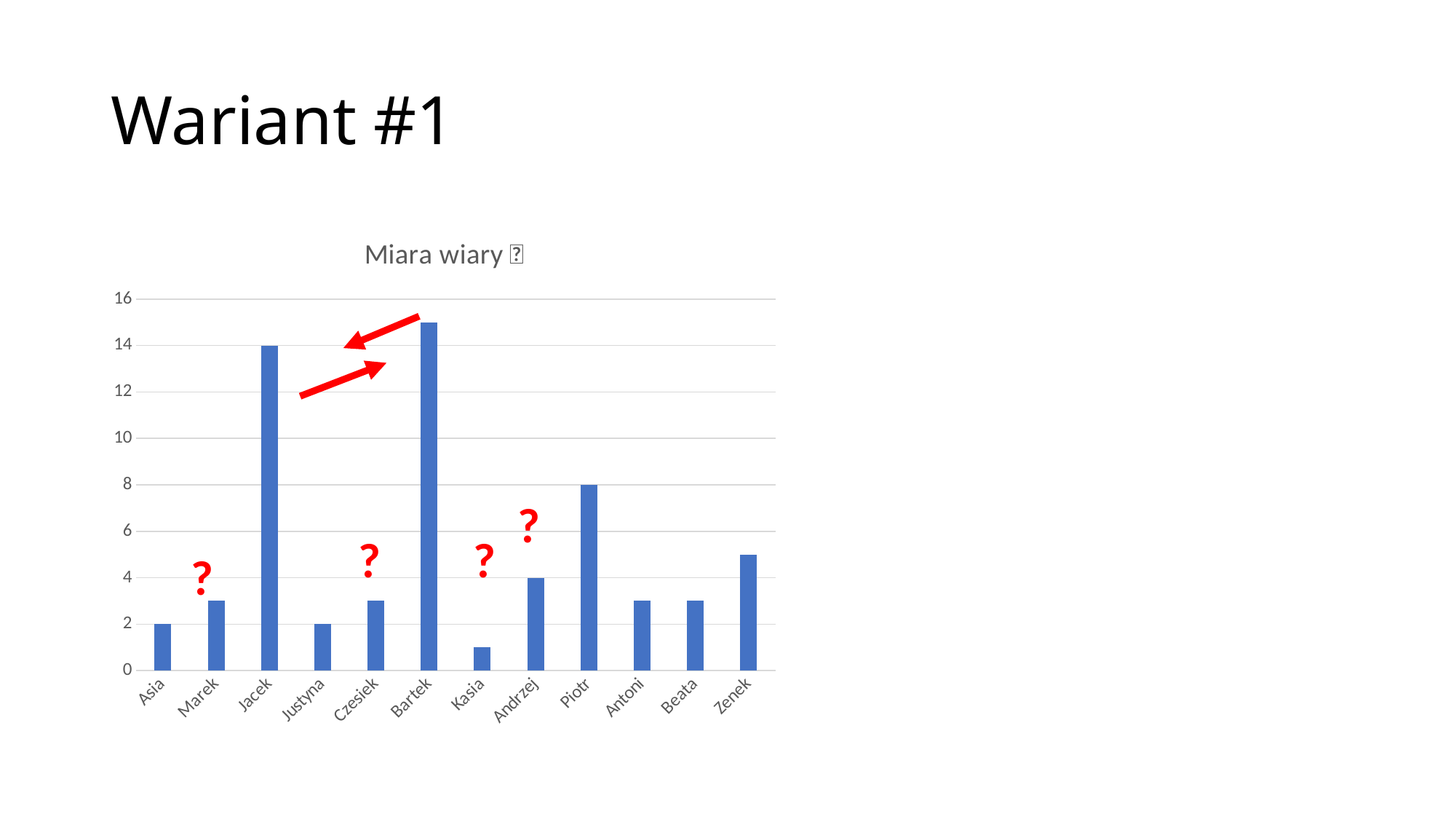
What is the value for Andrzej? 4 What is the difference between the values for Piotr and Andrzej? 4 How many categories (people) are shown on the x axis of the chart? 12 Which is larger, the value for Piotr or the value for Zenek? Piotr Which person has the highest bar in the chart? Bartek Which person has the lowest bar in the chart? Kasia What is the value for Piotr? 8 Is the value for Zenek greater or less than 4? greater What is the value for Jacek? 14 What type of chart is shown on the slide? bar chart Is the value for Bartek greater or less than 14? greater What is the value for Asia? 2